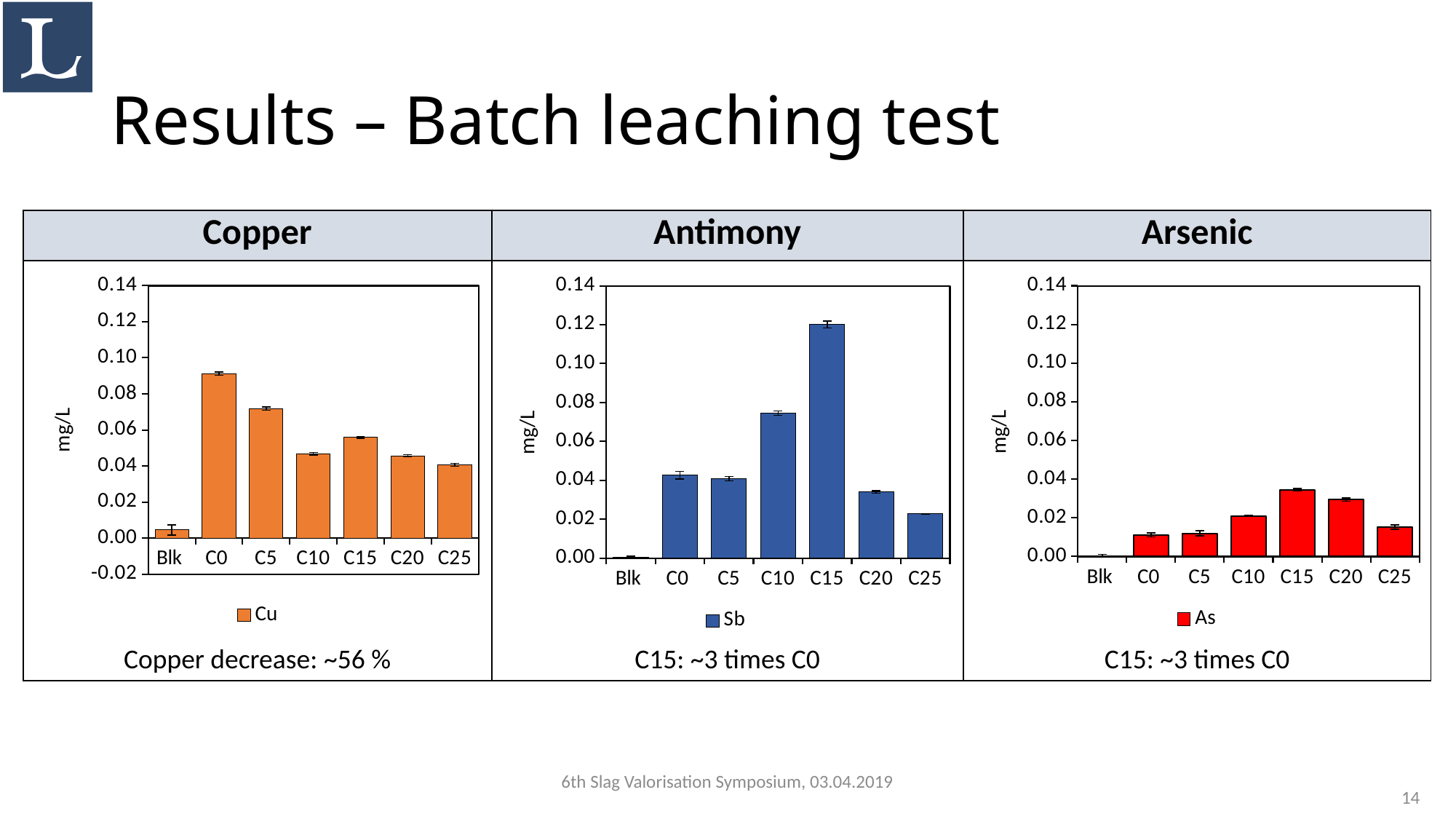
In the Arsenic chart, is the value for C15 greater or less than 0.04? less In the Antimony chart, is the value for C15 greater or less than 0.10? greater In the Copper chart, which is larger, the value for C0 or the value for C5? C0 What is the legend entry of the Arsenic chart? As In the Copper chart, which category has the highest value? C0 In the Antimony chart, which category has the highest value? C15 What kind of chart is the Copper chart? bar chart How many series does the legend of the Antimony chart list? 1 In the Antimony chart, which is larger, the value for C10 or the value for C20? C10 In the Copper chart, is the value for C0 greater or less than 0.08? greater How many categories are shown on the x axis of the Arsenic chart? 7 In the Arsenic chart, which category has the lowest value? Blk